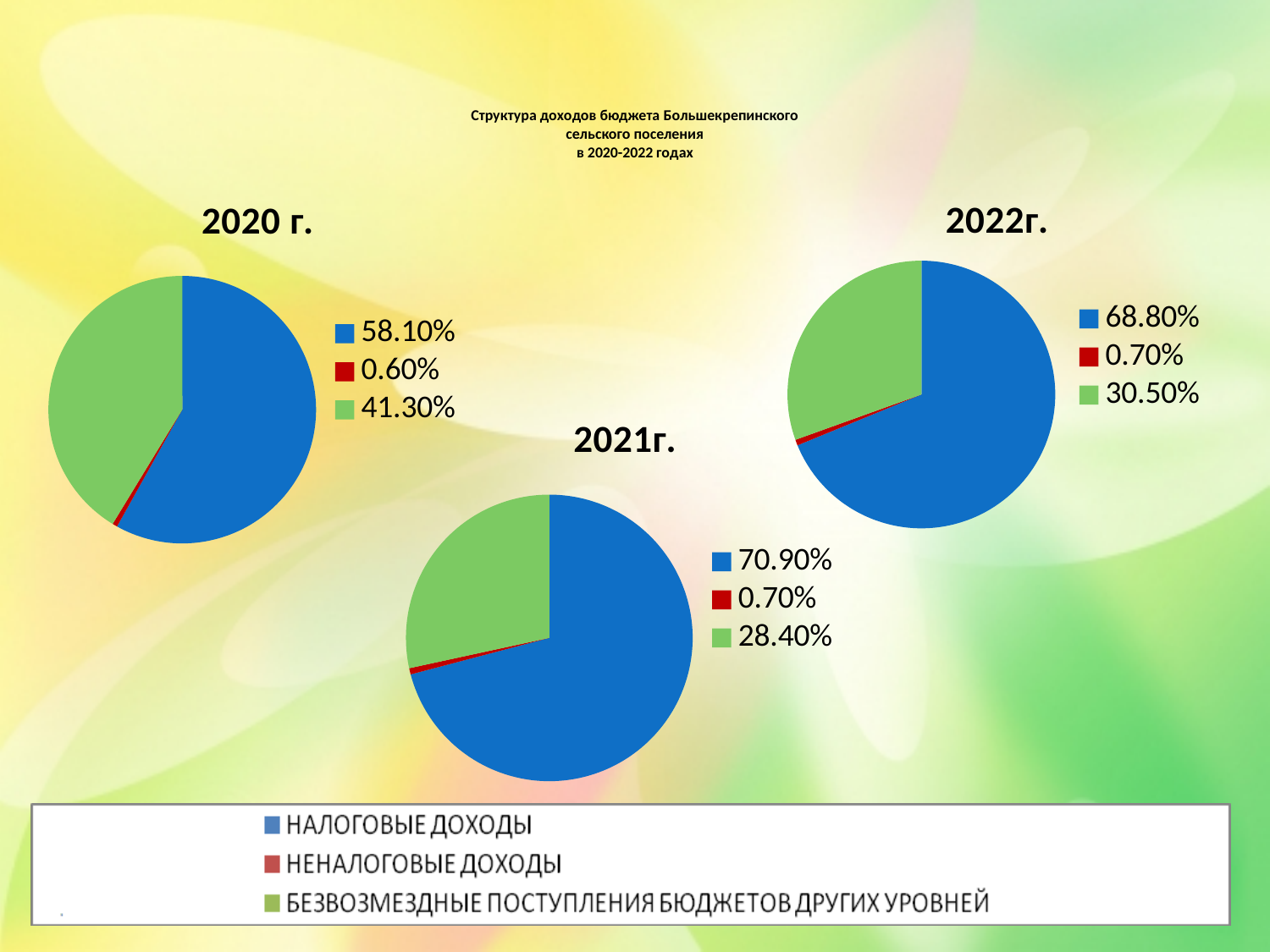
How many slices does the 2022г. pie chart have? 3 In the 2022г. chart, which category has the largest slice? НАЛОГОВЫЕ ДОХОДЫ In the 2021г. chart, which category has the smallest slice? НЕНАЛОГОВЫЕ ДОХОДЫ How many categories does the shared legend at the bottom of the slide list? 3 Which colour represents НЕНАЛОГОВЫЕ ДОХОДЫ in the pie charts? red In the 2021г. chart, what is the share of НЕНАЛОГОВЫЕ ДОХОДЫ (red slice)? 0.70% In the 2020 г. chart, what is the share of БЕЗВОЗМЕЗДНЫЕ ПОСТУПЛЕНИЯ БЮДЖЕТОВ ДРУГИХ УРОВНЕЙ (green slice)? 41.30% Which is larger: the green slice in the 2020 г. chart or the green slice in the 2022г. chart? 2020 г. What is the difference between the НАЛОГОВЫЕ ДОХОДЫ share in the 2021г. chart and in the 2020 г. chart? 12.80% In the 2022г. chart, what is the share of НАЛОГОВЫЕ ДОХОДЫ (blue slice)? 68.80% In the 2020 г. chart, what is the share of НАЛОГОВЫЕ ДОХОДЫ (blue slice)? 58.10% What kind of chart is used for the 2020 г. chart? pie chart